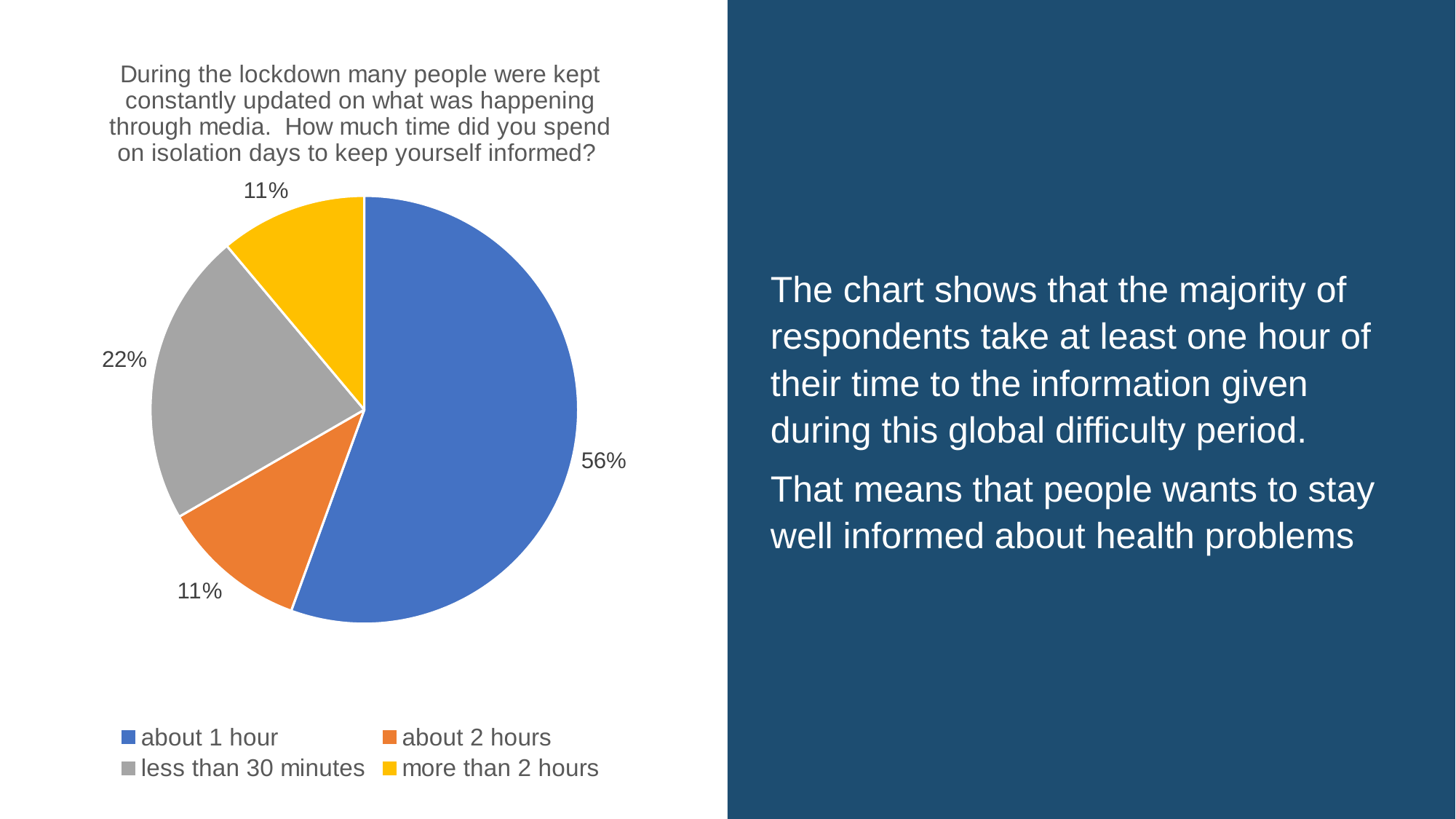
What share of respondents spent about 2 hours keeping themselves informed? 11% Which colour represents 'more than 2 hours' in the pie chart? yellow Which category has the largest share of the pie? about 1 hour What share of respondents spent more than 2 hours keeping themselves informed? 11% How many categories does the pie chart show? 4 Which is larger: the share for 'less than 30 minutes' or the share for 'about 2 hours'? less than 30 minutes What share of respondents spent less than 30 minutes keeping themselves informed? 22% How many entries does the legend list? 4 What type of chart is shown on the slide? pie chart What is the difference in percentage points between the 'about 1 hour' slice and the 'less than 30 minutes' slice? 34 Which colour represents 'about 1 hour' in the pie chart? blue What share of respondents spent about 1 hour keeping themselves informed? 56%